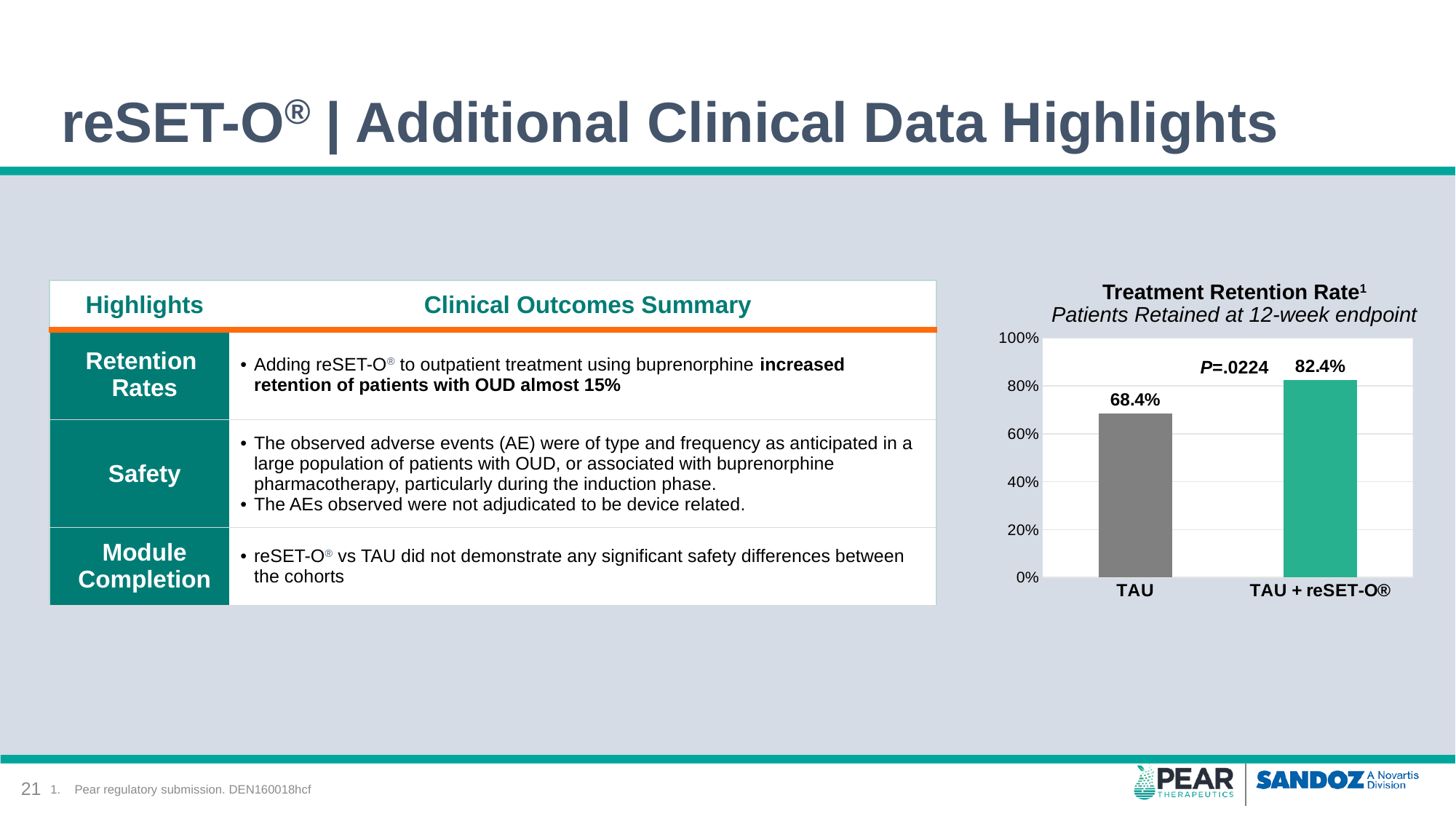
What kind of chart is the Treatment Retention Rate chart? bar chart What is the treatment retention rate for TAU? 68.4% What is the subtitle of the Treatment Retention Rate chart? Patients Retained at 12-week endpoint Is the retention rate for TAU + reSET-O® greater or less than 80%? greater Which group has the lower treatment retention rate? TAU What is the maximum value shown on the y-axis of the Treatment Retention Rate chart? 100% Is the retention rate for TAU greater or less than 80%? less Which group has the higher treatment retention rate? TAU + reSET-O® How many groups are shown in the Treatment Retention Rate chart? 2 What P value is shown on the Treatment Retention Rate chart? P=.0224 What is the treatment retention rate for TAU + reSET-O®? 82.4% What is the difference in retention rate between TAU + reSET-O® and TAU? 14.0%